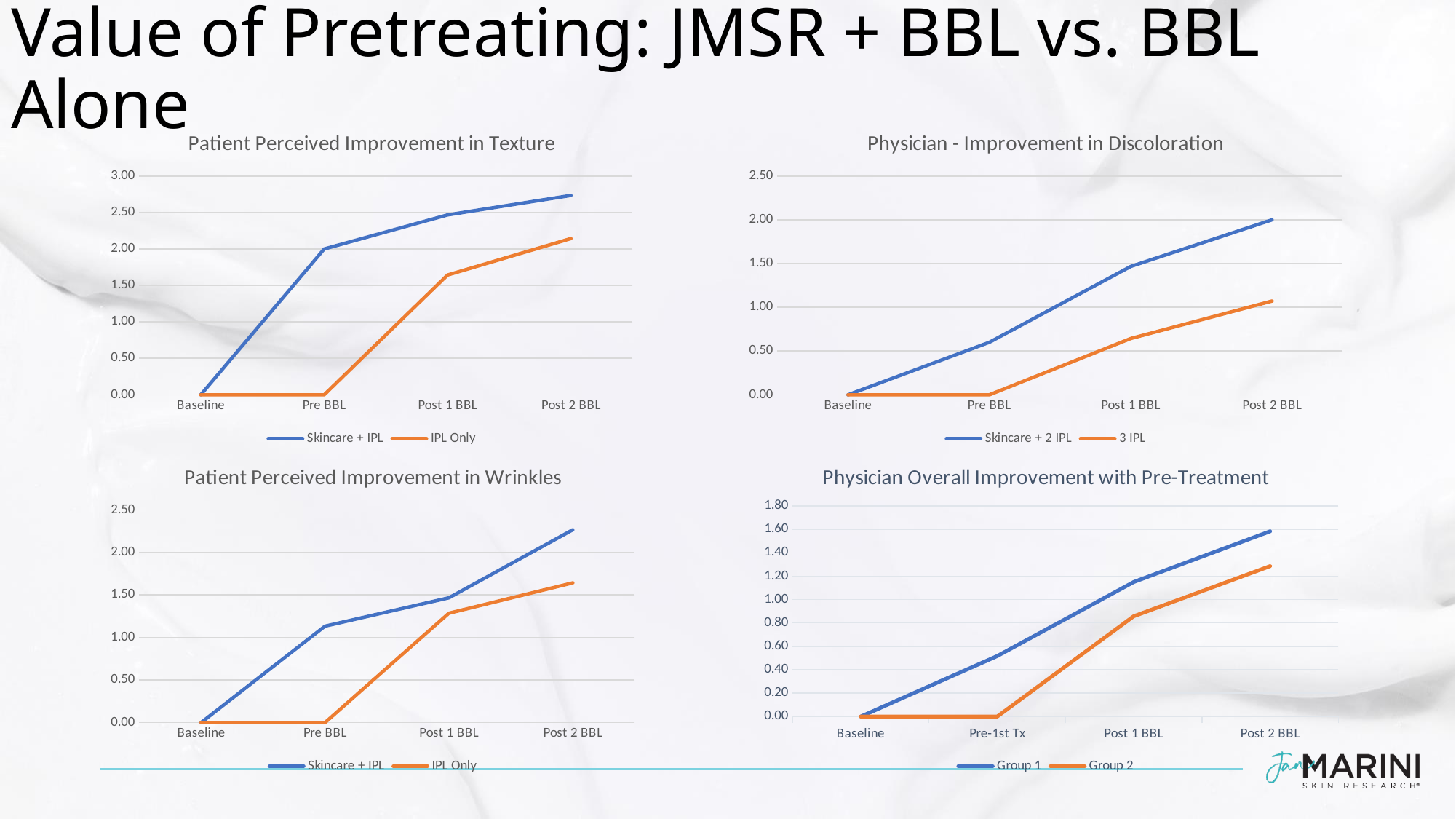
In "Patient Perceived Improvement in Texture", is the value for Skincare + IPL at Post 2 BBL greater or less than 2.50? greater In "Physician - Improvement in Discoloration", is the value for 3 IPL at Post 2 BBL greater or less than 1.50? less What are the two legend entries in "Physician Overall Improvement with Pre-Treatment"? Group 1 and Group 2 In "Physician - Improvement in Discoloration", does the Skincare + 2 IPL line rise or fall from Baseline to Post 2 BBL? rise In "Patient Perceived Improvement in Wrinkles", at which x-axis point is the IPL Only line highest? Post 2 BBL In "Patient Perceived Improvement in Texture", which series is higher at Post 1 BBL, Skincare + IPL or IPL Only? Skincare + IPL What type of chart is "Patient Perceived Improvement in Texture"? line chart How many points are on the x axis of "Physician Overall Improvement with Pre-Treatment"? 4 How many series does the legend of "Physician - Improvement in Discoloration" list? 2 In "Patient Perceived Improvement in Texture", what is the value for IPL Only at Pre BBL? 0.00 In "Physician Overall Improvement with Pre-Treatment", is the value for Group 2 at Post 1 BBL greater or less than 1.00? less